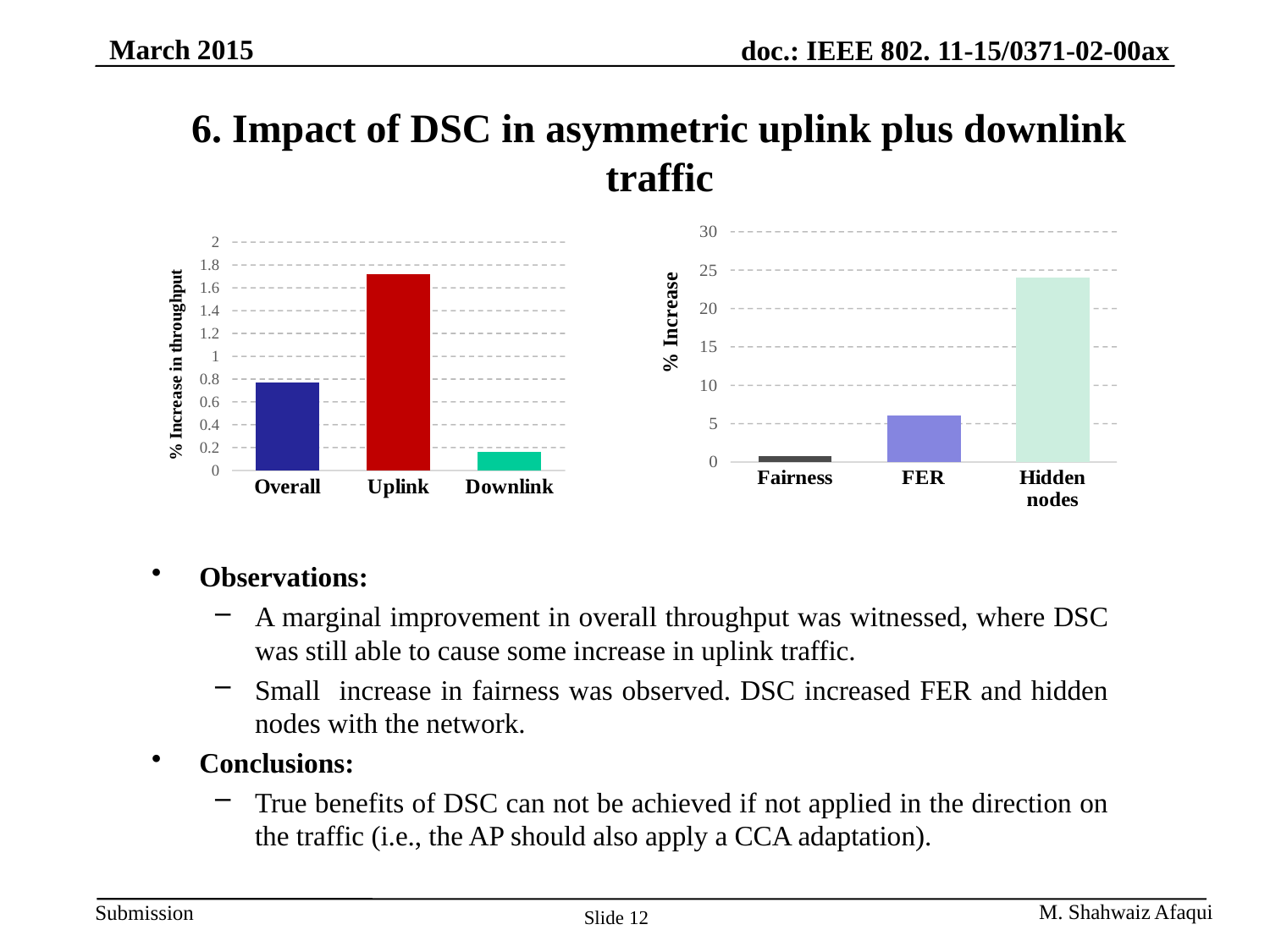
In the right chart, which category has the highest value? Hidden nodes What type of chart is the right chart? Bar chart In the left chart, which category has the lowest value? Downlink In the left chart, is the value for Uplink greater or less than 1.6? greater In the right chart, which category has the lowest value? Fairness How many categories are shown in the left chart? 3 In the left chart, which category has the highest value? Uplink In the left chart, is the value for Overall greater or less than 1? less In the left chart, which is larger, the value for Overall or the value for Downlink? Overall In the right chart, is the value for Hidden nodes greater or less than 20? greater